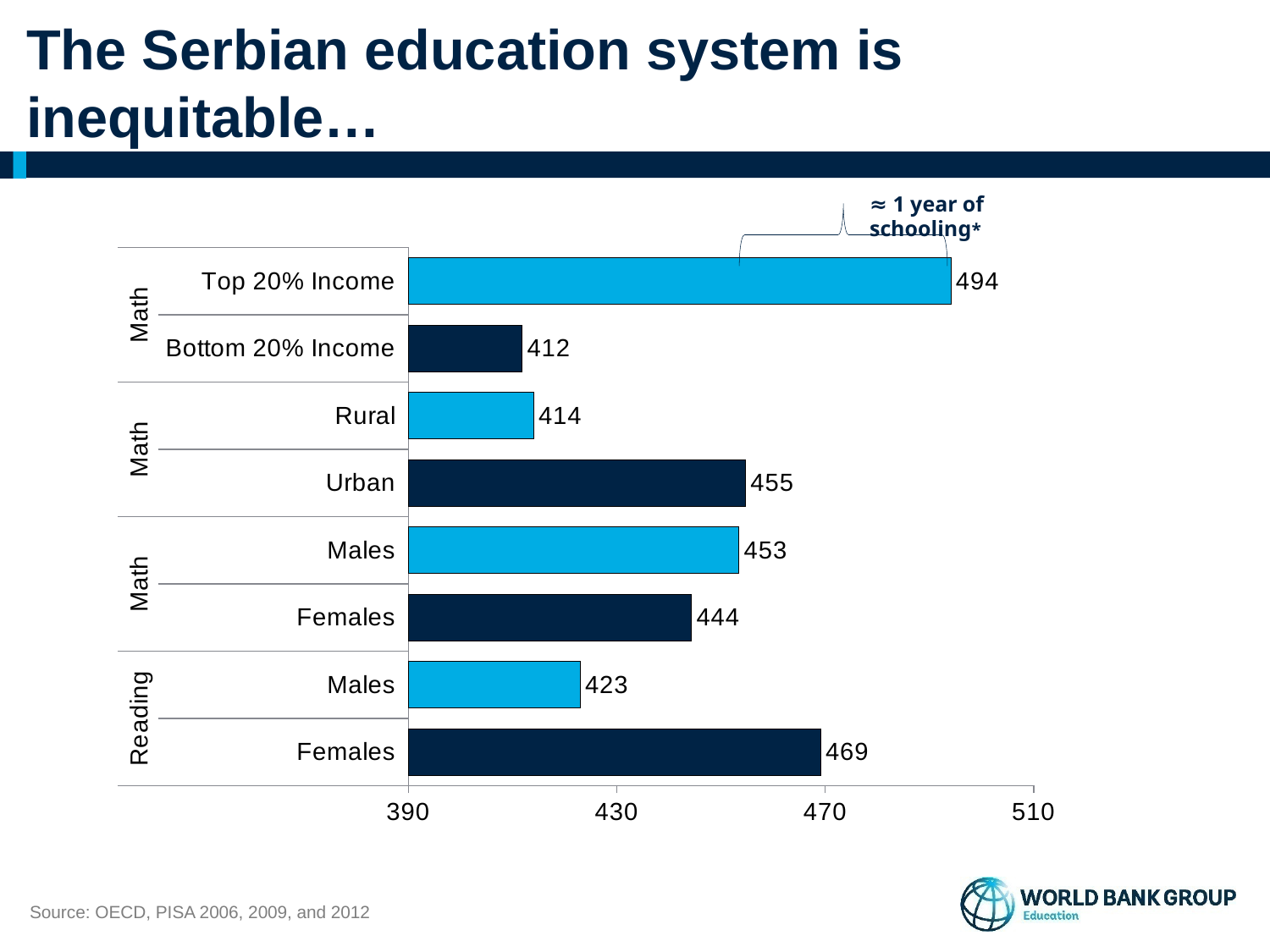
In Math, which scored higher, Urban or Rural students? Urban What is the Math score for Rural students? 414 What is the difference between the Reading scores of Females and Males? 46 Which category has the lowest score on the chart? Bottom 20% Income What type of chart is shown on the slide? Bar chart What is the Reading score for Females? 469 What is the source cited for the chart data? OECD, PISA 2006, 2009, and 2012 What is the Math score for the Top 20% Income group? 494 What is the difference between the Math scores of the Top 20% Income and Bottom 20% Income groups? 82 What is the Math score for the Bottom 20% Income group? 412 Which category has the highest score on the chart? Top 20% Income How many bars are plotted on the chart? 8